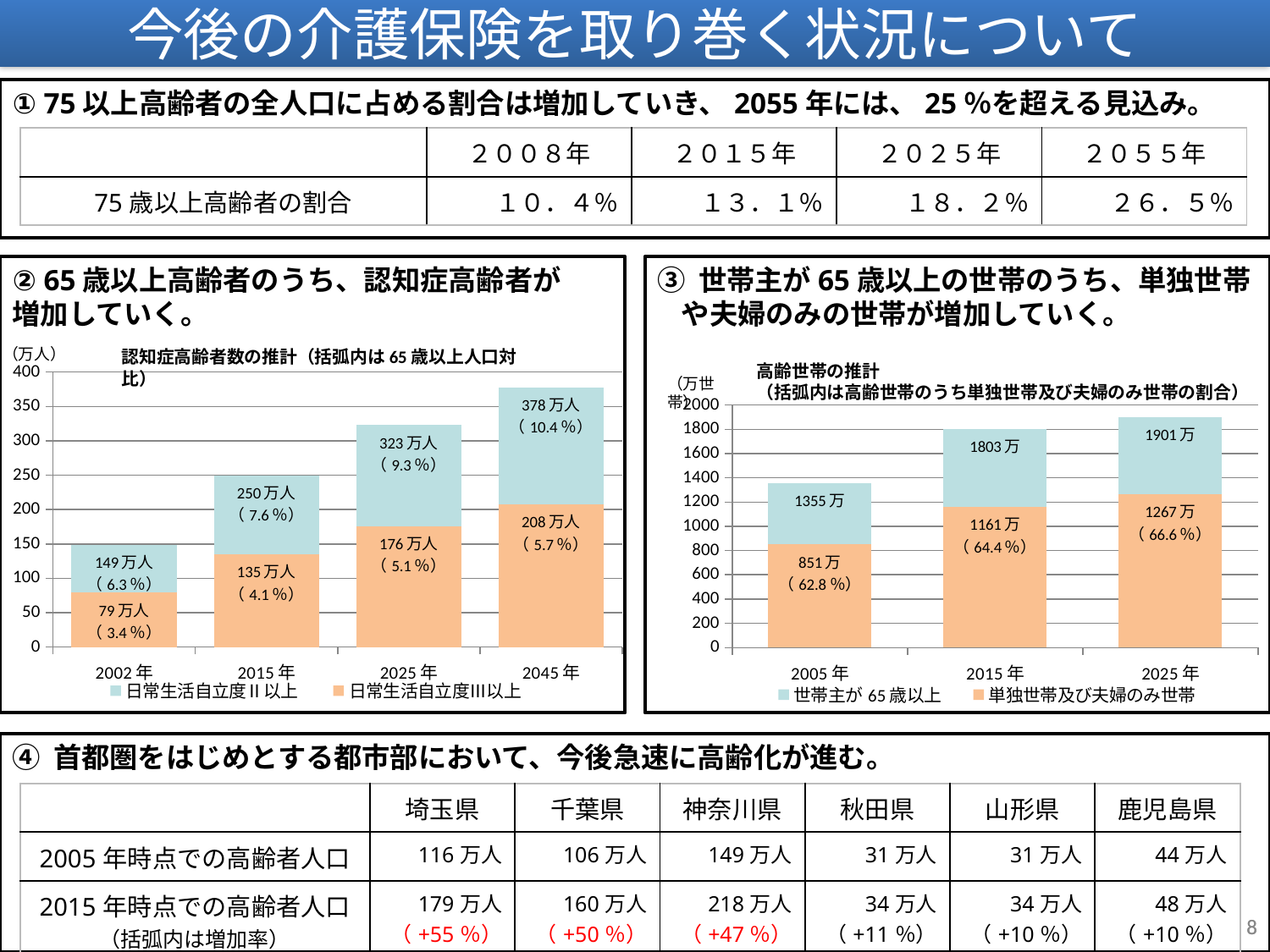
In the right chart (高齢世帯の推計), what is the difference between the 世帯主が65歳以上 values for 2025年 and 2005年? 546万 In the left chart (認知症高齢者数の推計), which year has the highest value for 日常生活自立度Ⅱ以上? 2045年 In the left chart (認知症高齢者数の推計), what percentage is shown in parentheses for 日常生活自立度Ⅲ以上 in 2025年? 5.1% In the left chart (認知症高齢者数の推計), what is the value labelled for 日常生活自立度Ⅱ以上 in 2045年? 378万人 In the right chart (高齢世帯の推計), which year has the lowest value for 単独世帯及び夫婦のみ世帯? 2005年 In the left chart (認知症高齢者数の推計), how many years are shown on the x axis? 4 In the left chart (認知症高齢者数の推計), what is the value labelled for 日常生活自立度Ⅲ以上 in 2002年? 79万人 In the left chart (認知症高齢者数の推計), what is the difference between the 日常生活自立度Ⅲ以上 values for 2045年 and 2015年? 73万人 In the right chart (高齢世帯の推計), what percentage is shown in parentheses for 単独世帯及び夫婦のみ世帯 in 2025年? 66.6% In the right chart (高齢世帯の推計), what is the value labelled for 世帯主が65歳以上 in 2015年? 1803万 In the right chart (高齢世帯の推計), how many series does the legend list? 2 In the left chart (認知症高齢者数の推計), do the 日常生活自立度Ⅱ以上 values rise or fall from 2002年 to 2045年? rise